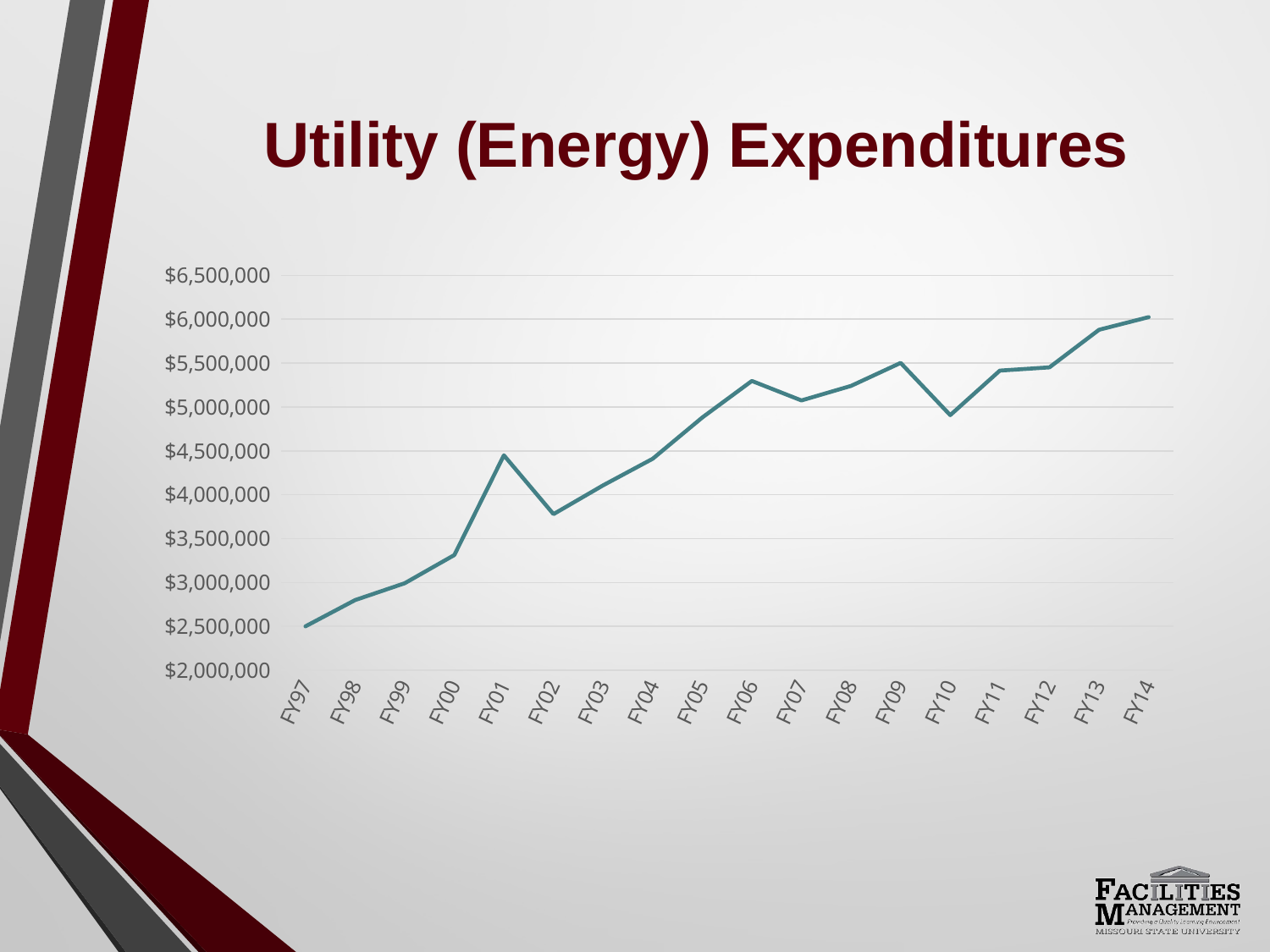
Is the value for FY13 greater or less than $5,500,000? greater What is the title of the chart? Utility (Energy) Expenditures How many fiscal years are plotted on the x axis? 18 Which is larger, the value for FY01 or the value for FY02? FY01 Which is larger, the value for FY09 or the value for FY10? FY09 What kind of chart is shown on the slide? line chart Which fiscal year has the highest utility expenditure? FY14 Is the value for FY02 greater or less than $4,000,000? less Overall, do utility expenditures rise or fall from FY97 to FY14? rise Is the value for FY01 greater or less than $4,000,000? greater Which fiscal year has the lowest utility expenditure? FY97